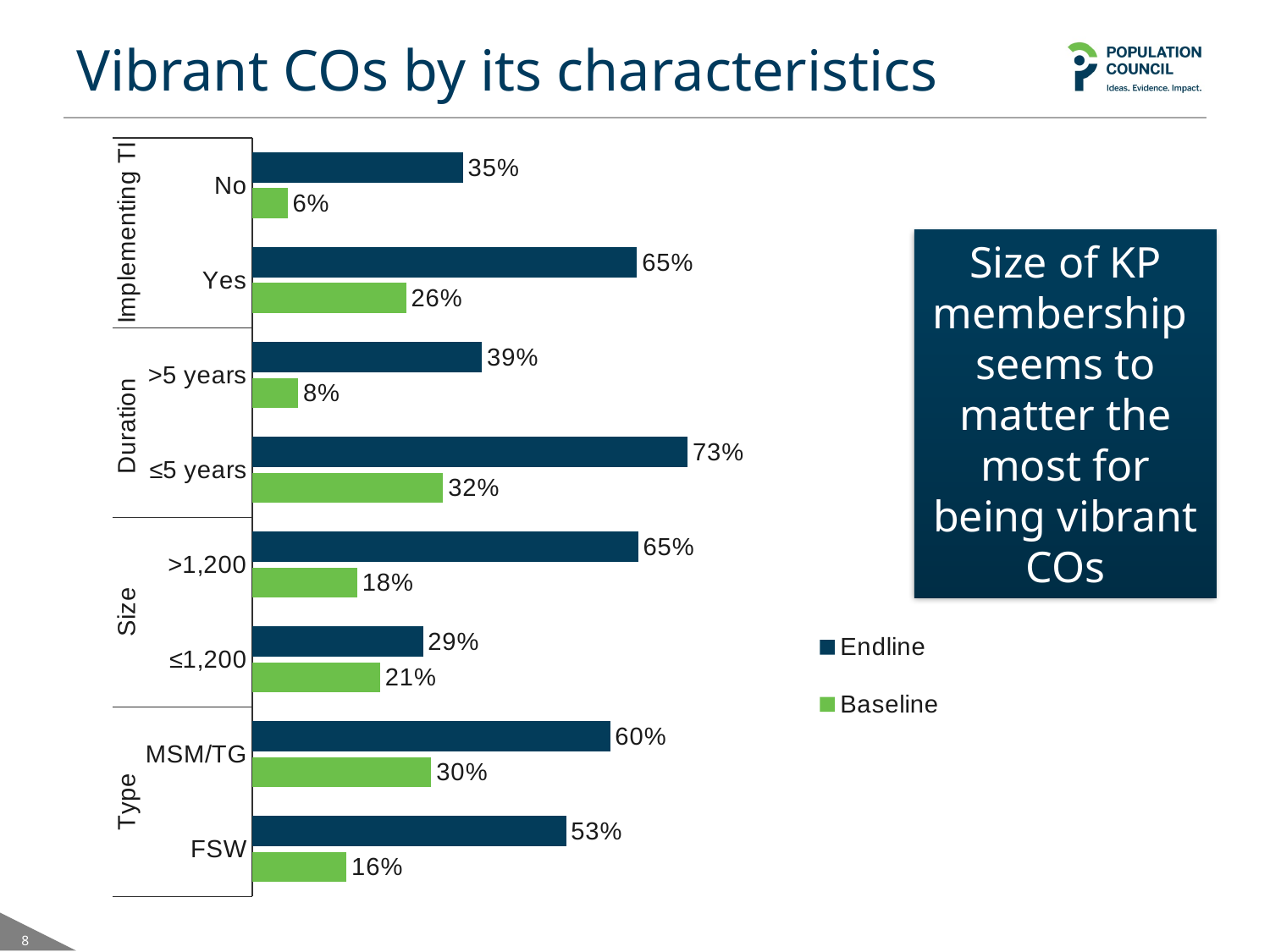
How many series does the legend list? 2 What is the Baseline value for COs not implementing TI (No)? 6% What is the difference between the Endline and Baseline values for MSM/TG? 30% Which category has the lowest Baseline value? No Which colour represents the Baseline series? Green Which is larger, the Baseline value for ≤5 years or the Baseline value for >5 years? ≤5 years What is the Baseline value for COs with size >1,200? 18% What kind of chart is shown on the slide? Bar chart Which category has the highest Endline value? ≤5 years How many categories are shown on the chart? 8 What is the difference between the Endline values for size >1,200 and size ≤1,200? 36% What is the Endline value for FSW? 53%